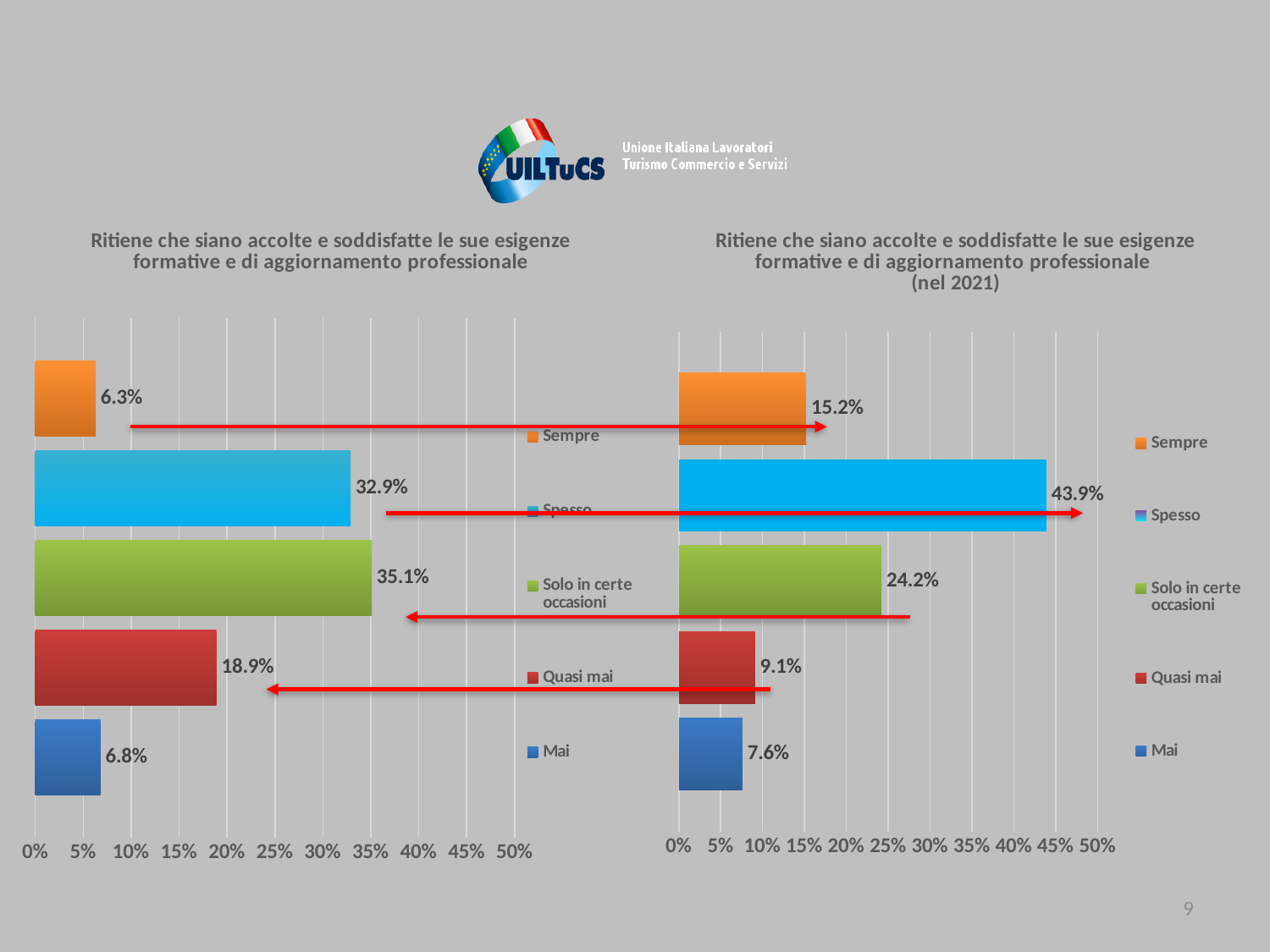
In the right chart (nel 2021), what is the value for Sempre? 15.2% In the left chart, what is the difference between Solo in certe occasioni and Quasi mai? 16.2 percentage points What type of chart is the right chart (nel 2021)? Bar chart In the left chart, which category has the highest value? Solo in certe occasioni In the right chart (nel 2021), what is the value for Quasi mai? 9.1% How many categories does the left chart show? 5 In the right chart (nel 2021), which category has the lowest value? Mai In the right chart (nel 2021), which category has the highest value? Spesso In the left chart, what colour is the bar for Mai? Blue In the left chart, what is the value for Spesso? 32.9% Which is larger: Quasi mai in the left chart or Quasi mai in the right chart (nel 2021)? Left chart What is the difference between the Spesso values in the right chart (nel 2021) and the left chart? 11 percentage points